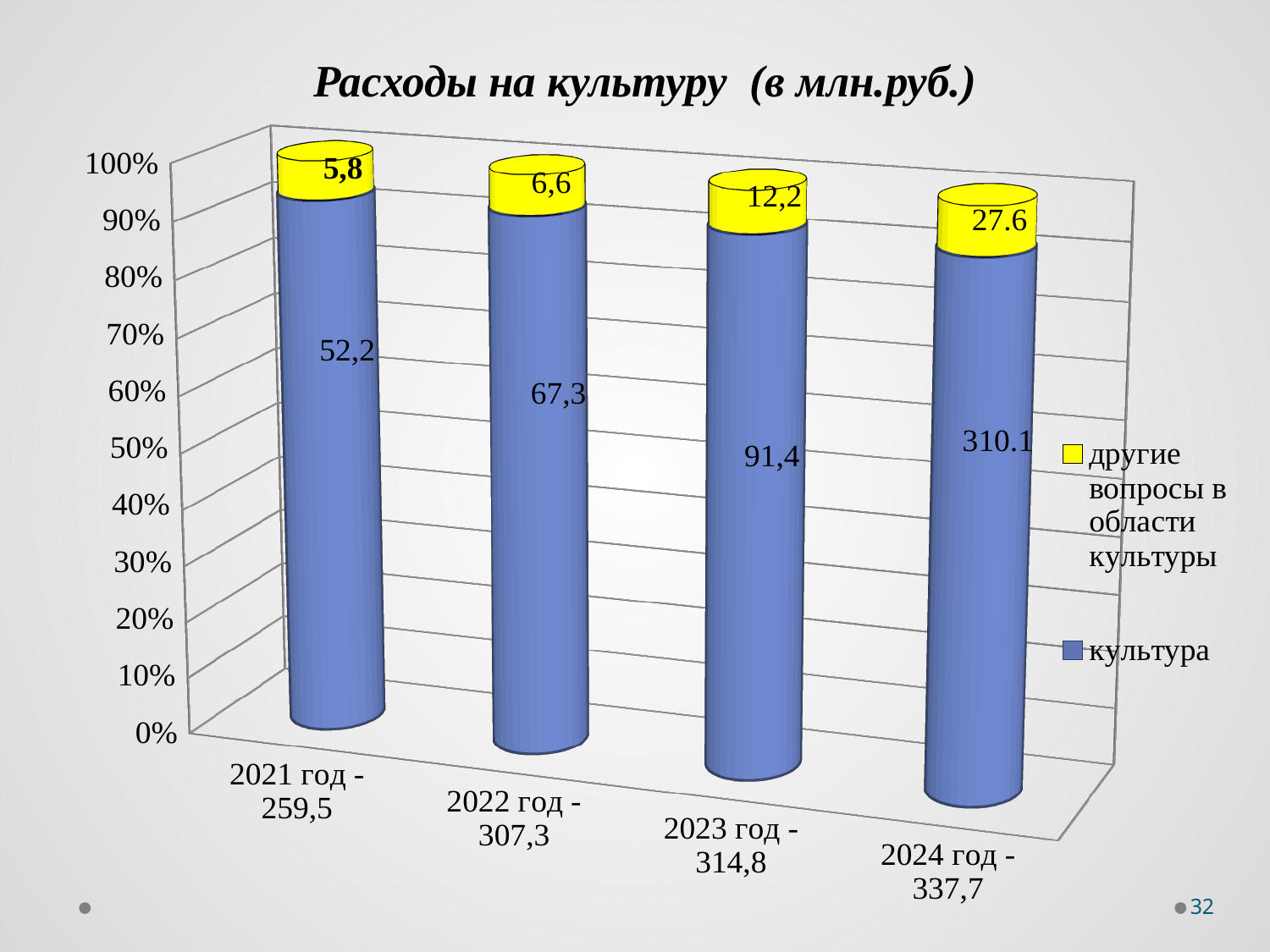
What is the value of the "культура" series for "2021 год - 259,5"? 52,2 Which year has the highest value for the "другие вопросы в области культуры" series? 2024 год - 337,7 Do the values of the "другие вопросы в области культуры" series rise or fall from 2021 to 2024? Rise How many series does the legend list? 2 What is the value of the "культура" series for "2023 год - 314,8"? 91,4 What kind of chart is shown on the slide? Stacked bar chart What is the value of the "другие вопросы в области культуры" series for "2024 год - 337,7"? 27.6 What is the difference between the "другие вопросы в области культуры" values for 2023 and 2022? 5,6 What is the value of the "другие вопросы в области культуры" series for "2022 год - 307,3"? 6,6 Which is larger: the "культура" value for 2022 or for 2023? 2023 How many years (categories) are shown on the x axis? 4 Which year has the lowest value for the "культура" series? 2021 год - 259,5